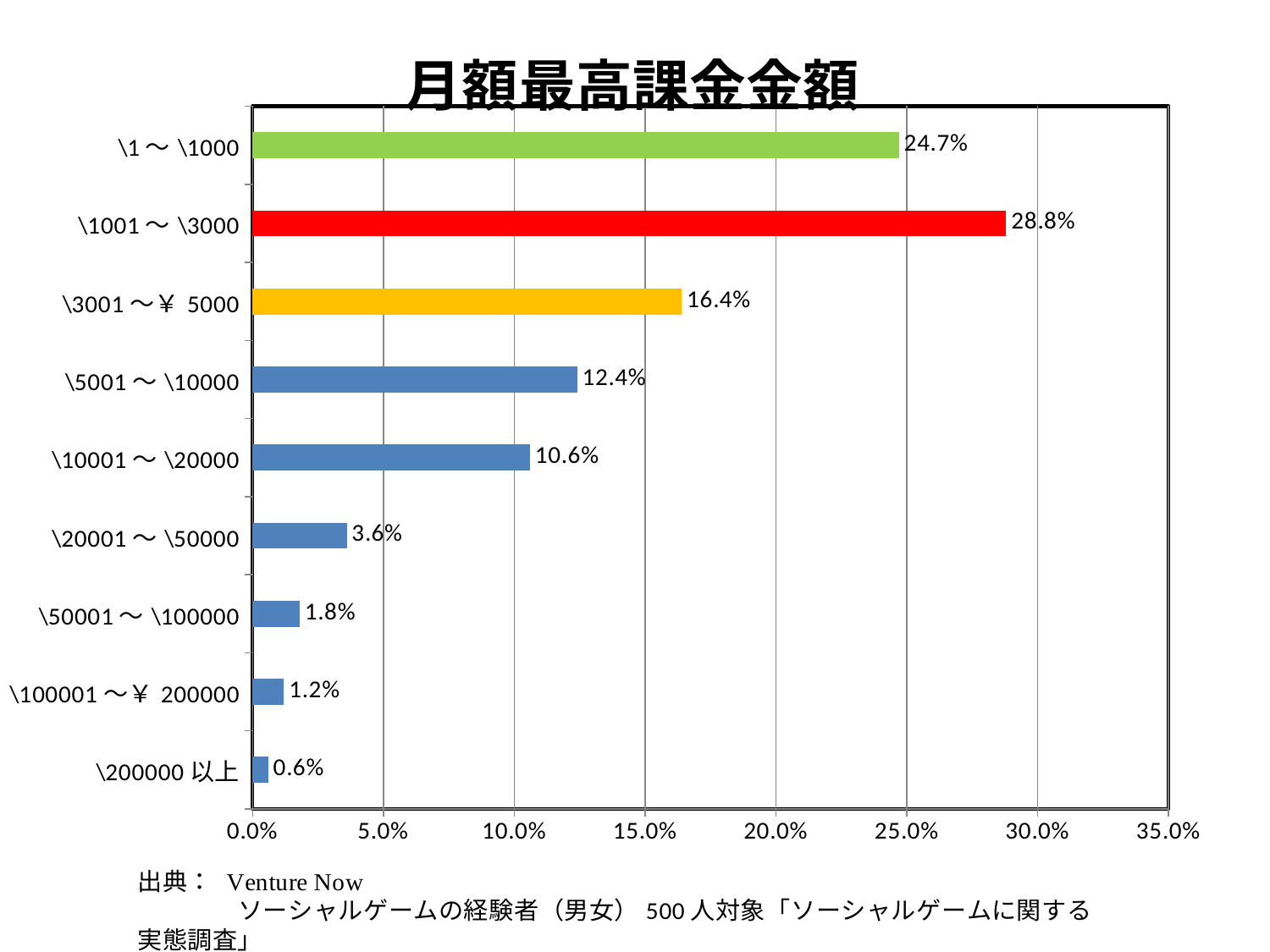
What is the value for the \1001～\3000 category? 28.8% What is the value for the \200000 以上 category? 0.6% Is the value for \1～\1000 greater or less than 20.0%? greater What is the title of the chart? 月額最高課金金額 Which category has the lowest value? \200000 以上 What colour is the bar for the \1001～\3000 category? red What kind of chart is shown on the slide? bar chart How many categories are shown in the chart? 9 What is the value for the \5001～\10000 category? 12.4% Which category has the highest value? \1001～\3000 What is the difference between the values for \1001～\3000 and \1～\1000? 4.1% Which is larger, the value for \3001～¥5000 or the value for \5001～\10000? \3001～¥5000